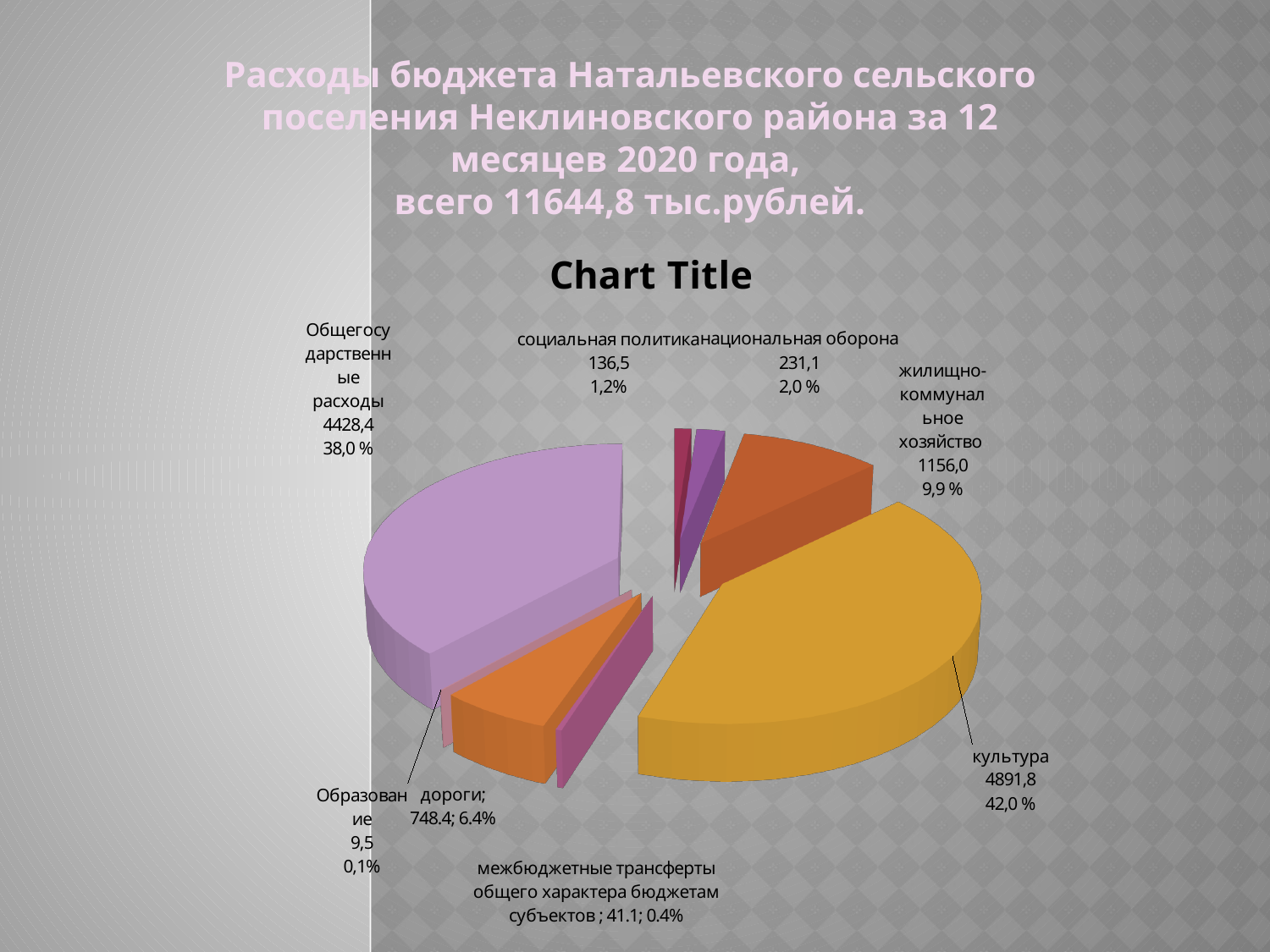
What share of the pie does дороги take? 6.4% What kind of chart is shown on the slide? pie chart Which category has the largest value? культура What is the chart's title as printed above the pie? Chart Title Which is larger, социальная политика or национальная оборона? национальная оборона What is the value for жилищно-коммунальное хозяйство? 1156,0 What is the value for культура? 4891,8 How many categories (slices) does the pie chart have? 8 What is the difference between the values for культура and Общегосударственные расходы? 463,4 Which category has the smallest value? Образование What is the value for национальная оборона? 231,1 What share of the pie does Общегосударственные расходы take? 38,0 %